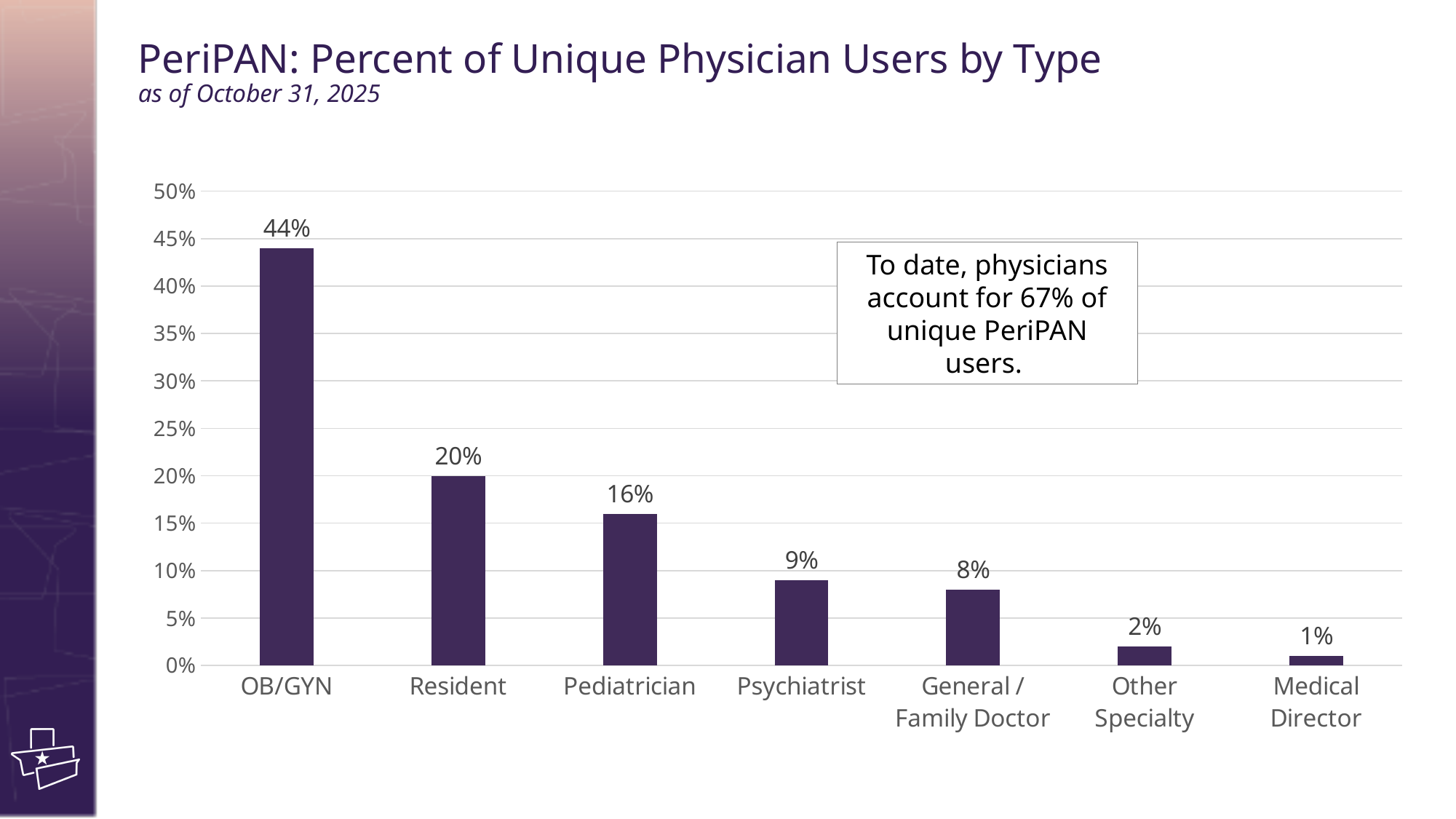
Which physician type has the lowest percent of unique users? Medical Director What kind of chart is shown on the slide? Bar chart What percent of unique physician users are OB/GYN? 44% Which physician type has the highest percent of unique users? OB/GYN Which is larger, the value for Resident or the value for Pediatrician? Resident What is the difference between the OB/GYN and Resident percentages? 24% According to the text box on the chart, what percent of unique PeriPAN users do physicians account for? 67% How many physician types are shown on the x axis? 7 What is the difference between the Pediatrician and General / Family Doctor percentages? 8% What percent of unique physician users are Psychiatrists? 9% What is the value shown for Pediatrician? 16% Is the value for Psychiatrist greater or less than 10%? less